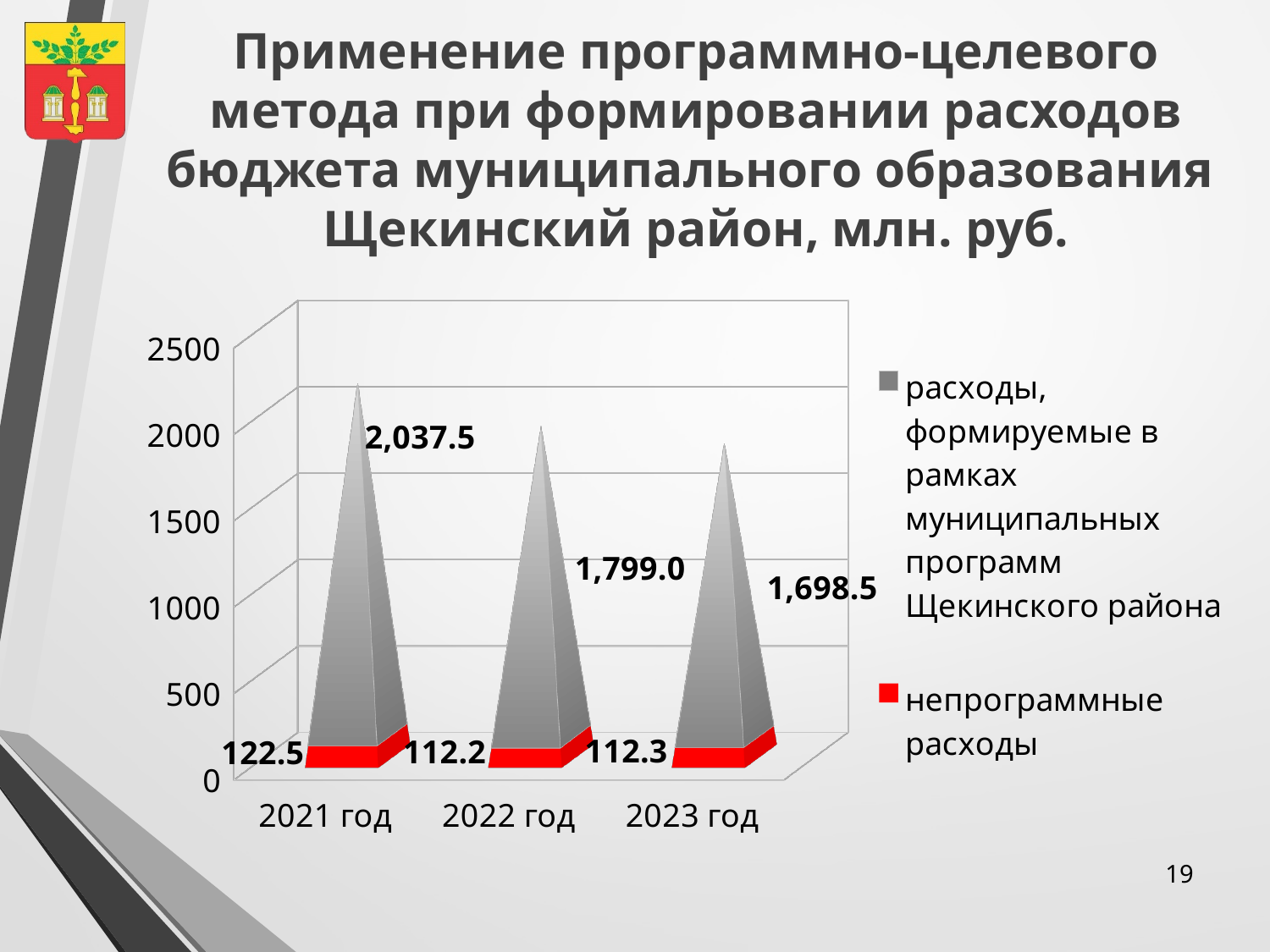
What is the value of непрограммные расходы for 2023 год? 112.3 How many series does the legend list? 2 What is the difference between the program expenses in 2021 год and 2022 год? 238.5 How many years are shown on the x axis? 3 Which is larger: the program expenses in 2022 год or in 2023 год? 2022 год What is the total of the stacked bar for 2022 год? 1,911.2 In which year are the непрограммные расходы the highest? 2021 год In which year are the расходы, формируемые в рамках муниципальных программ Щекинского района the lowest? 2023 год What is the value of расходы, формируемые в рамках муниципальных программ Щекинского района for 2023 год? 1,698.5 In which year are the расходы, формируемые в рамках муниципальных программ Щекинского района the highest? 2021 год What is the value of расходы, формируемые в рамках муниципальных программ Щекинского района for 2021 год? 2,037.5 What is the difference between непрограммные расходы in 2021 год and 2022 год? 10.3